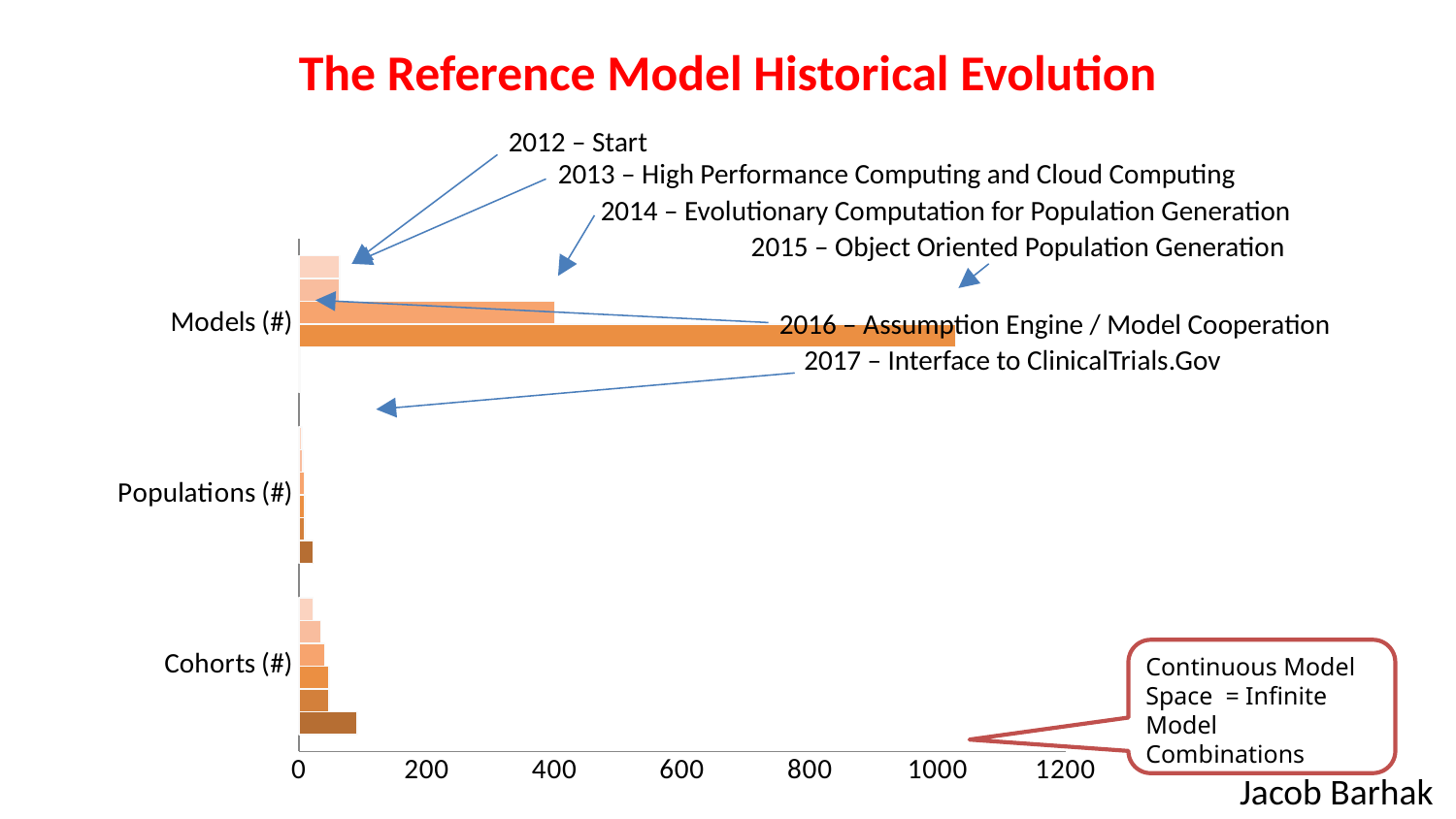
Do the bars for Cohorts (#) get longer or shorter going from the top bar to the bottom bar? Longer What is the title of the slide's chart? The Reference Model Historical Evolution What kind of chart is shown on the slide? Bar chart Which year is annotated as 'Start' on the chart? 2012 How many bars are drawn for the Models (#) category? 6 Which is longer: the longest bar for Cohorts (#) or the longest bar for Populations (#)? Cohorts (#) What is the highest value labelled on the horizontal axis? 1200 Is the longest bar for Models (#) greater or less than 800? greater Is the longest bar for Populations (#) greater or less than 200? less Is the longest bar for Cohorts (#) greater or less than 200? less How many categories are shown on the vertical axis of the chart? 3 Which category has the longest bar in the chart? Models (#)